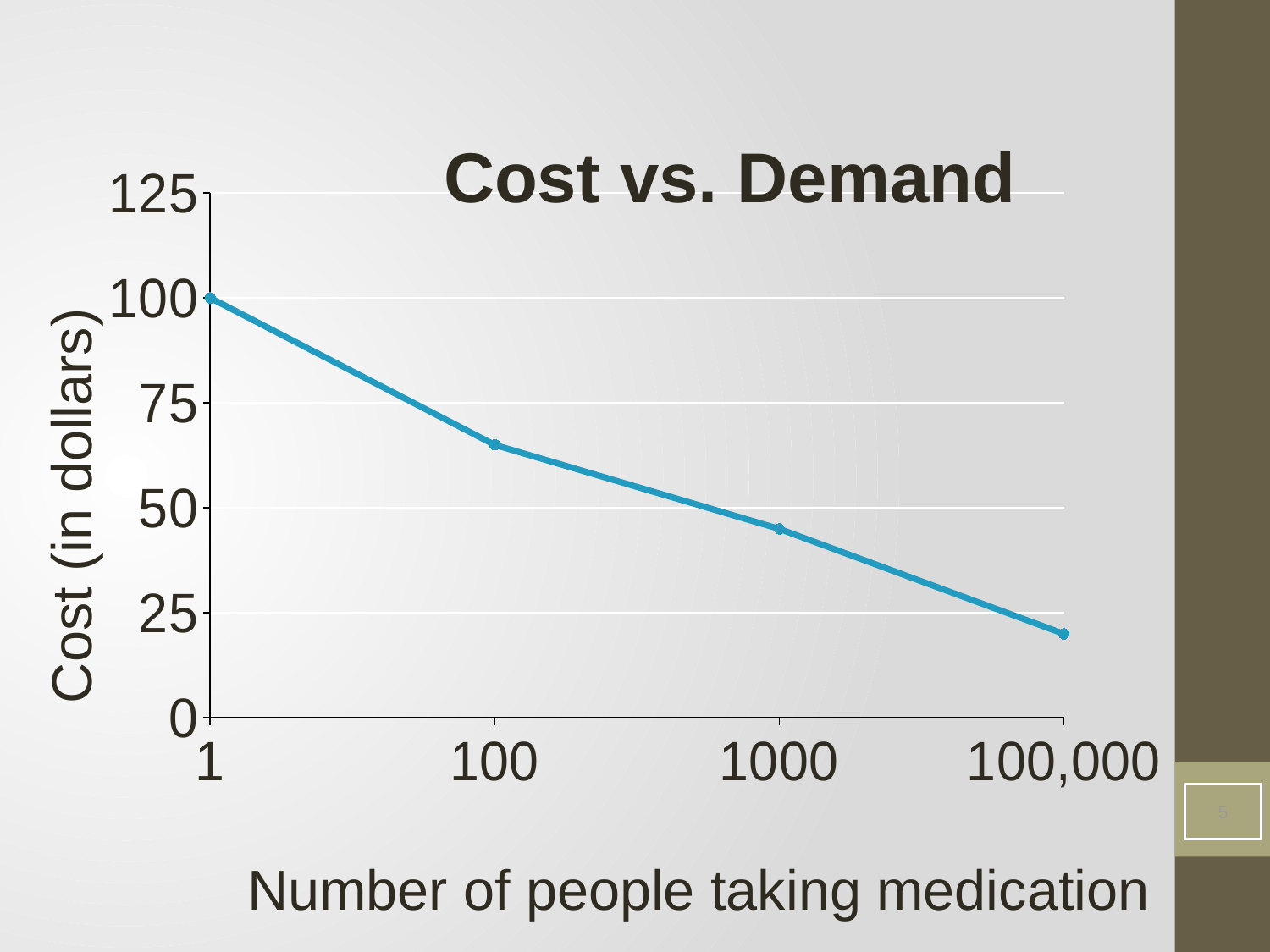
What kind of chart is shown on the slide? line chart How many data points are plotted on the line? 4 Is the cost for 100 people greater or less than 75? less Which has the higher cost: 100 people or 1000 people? 100 What is the label of the x axis? Number of people taking medication At which number of people taking medication is the cost highest? 1 What is the title of the chart? Cost vs. Demand Does the cost rise or fall as the number of people taking medication increases? fall Is the cost for 100,000 people greater or less than 25? less Is the cost for 1000 people greater or less than 50? less At which number of people taking medication is the cost lowest? 100,000 What is the cost when the number of people taking medication is 1? 100